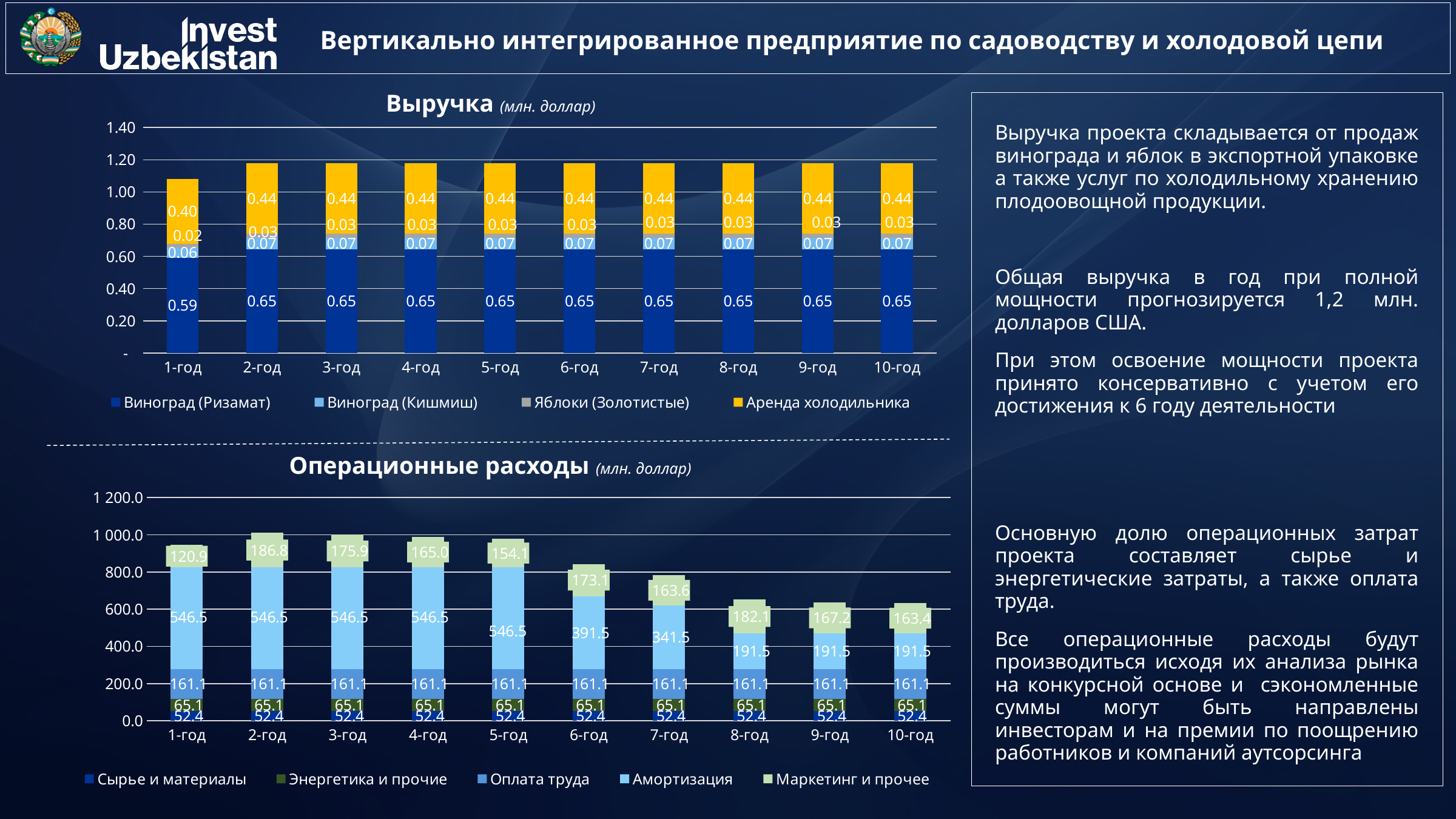
In the Выручка chart, what is the total of the stacked bar for 2-год? 1.19 In the Операционные расходы chart, which year has the highest Маркетинг и прочее value? 2-год In the Операционные расходы chart, what is the value for Амортизация in 7-год? 341.5 In the Выручка chart, how many series does the legend list? 4 In the Операционные расходы chart, is the total for 10-год greater or less than 800.0? less In the Выручка chart, what is the total of the stacked bar for 1-год? 1.07 In the Операционные расходы chart, how many categories are shown on the x axis? 10 In the Выручка chart, what is the difference between Виноград (Ризамат) in 2-год and in 1-год? 0.06 In the Выручка chart, what is the value for Аренда холодильника in 1-год? 0.40 In the Операционные расходы chart, what is the value for Маркетинг и прочее in 2-год? 186.8 In the Выручка chart, what is the value for Виноград (Ризамат) in 5-год? 0.65 What kind of chart is the Операционные расходы chart? Stacked bar chart